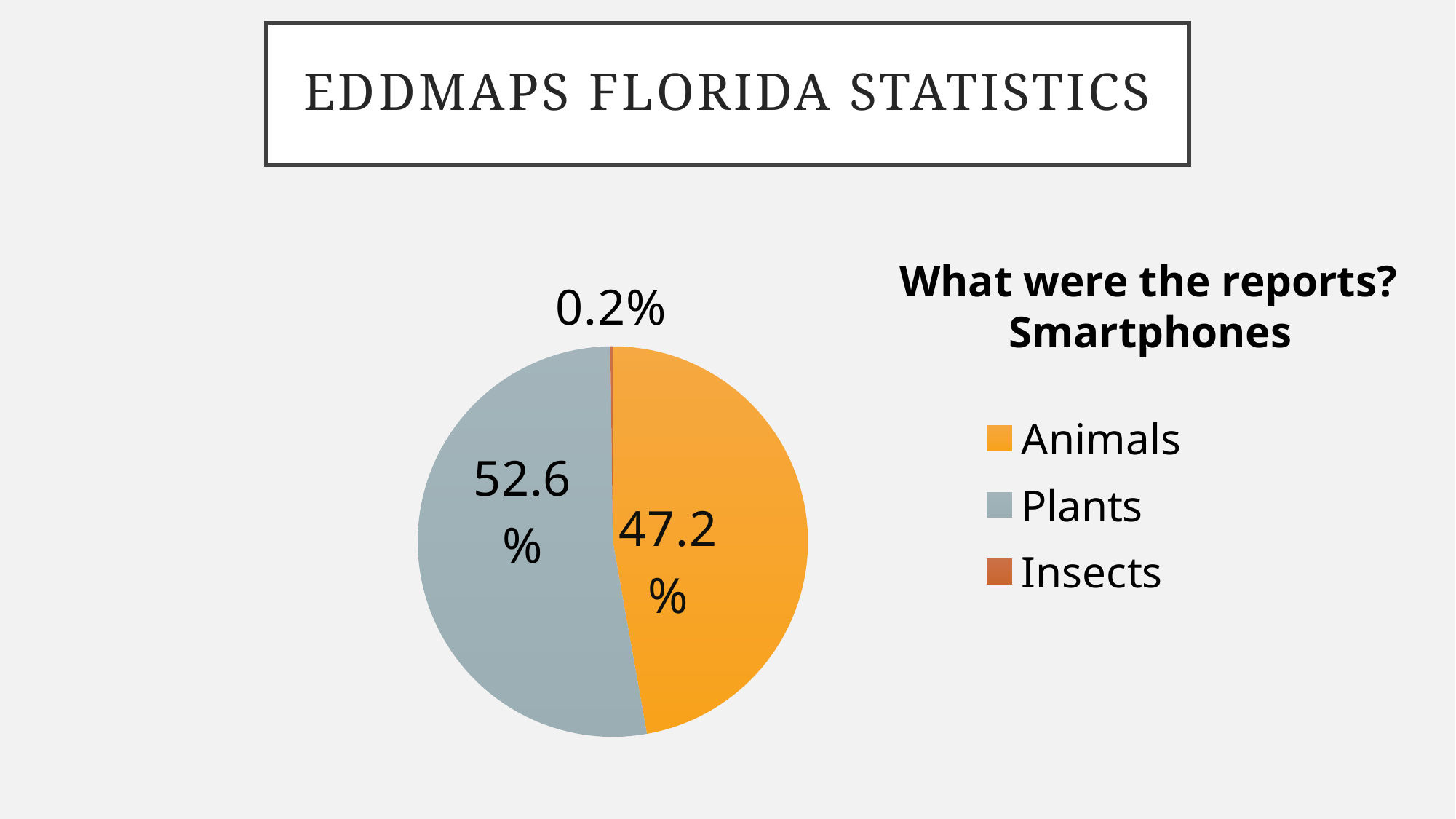
How many categories does the pie chart show? 3 What colour represents Animals in the pie chart? orange What is the title of the chart? What were the reports? Smartphones Which category has the smallest share of reports? Insects How many entries does the legend list? 3 Which category has the largest share of reports? Plants Which is larger, the share for Animals or the share for Plants? Plants What percentage of reports were Insects? 0.2% What percentage of reports were Plants? 52.6% What is the difference in percentage points between Plants and Animals? 5.4 What type of chart is shown on the slide? pie chart What percentage of reports were Animals? 47.2%